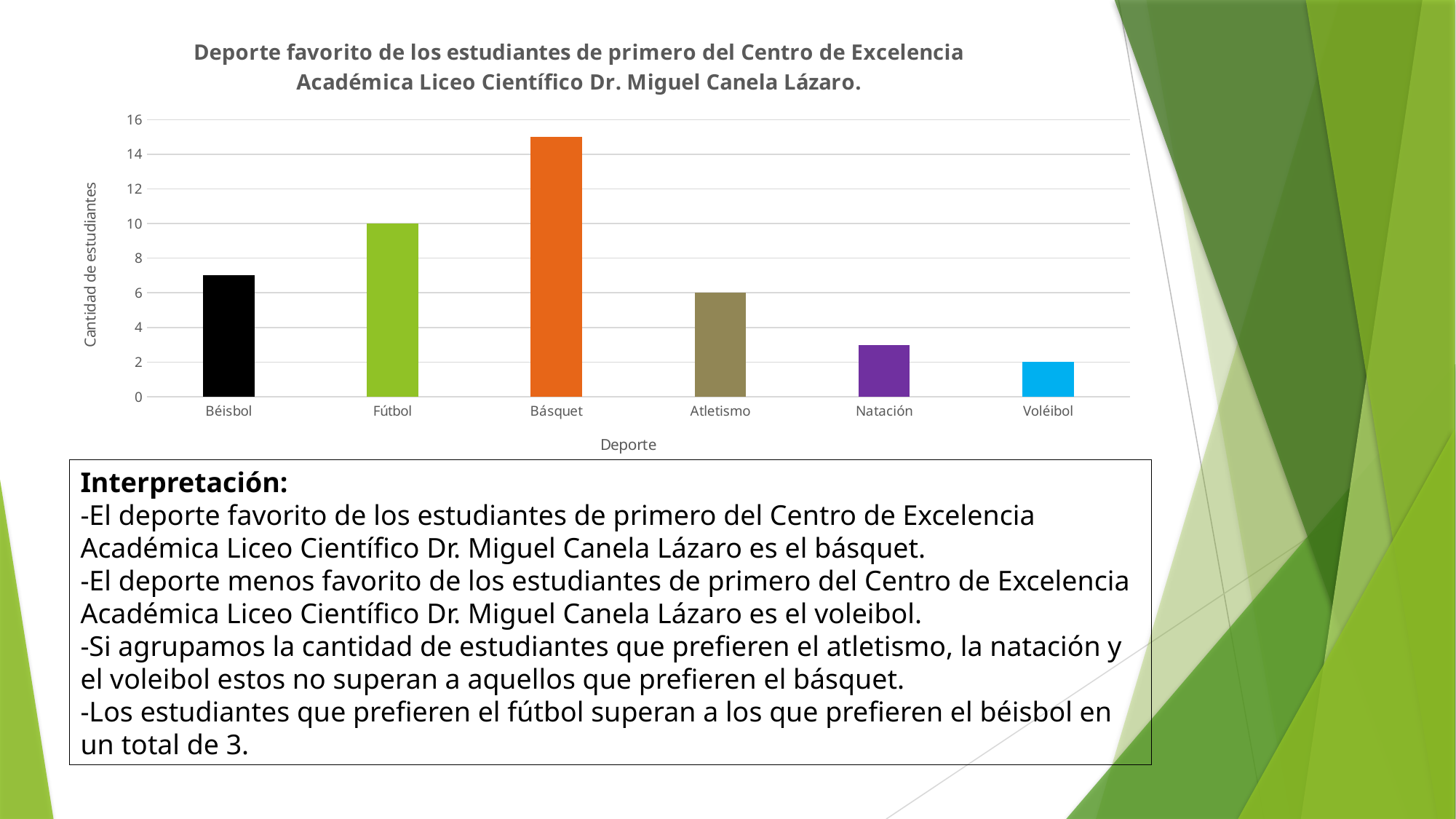
How many students chose Fútbol? 10 How many students chose Voléibol? 2 Which sport has the lowest number of students? Voléibol Is the value for Béisbol greater or less than 8? less Which sport has the highest number of students? Básquet Which has more students, Fútbol or Béisbol? Fútbol What type of chart is shown on the slide? bar chart Is the value for Básquet greater or less than 14? greater What is the difference between the number of students who chose Fútbol and those who chose Atletismo? 4 How many students chose Atletismo? 6 What is the label of the vertical axis? Cantidad de estudiantes How many sports (categories) are shown on the x axis? 6